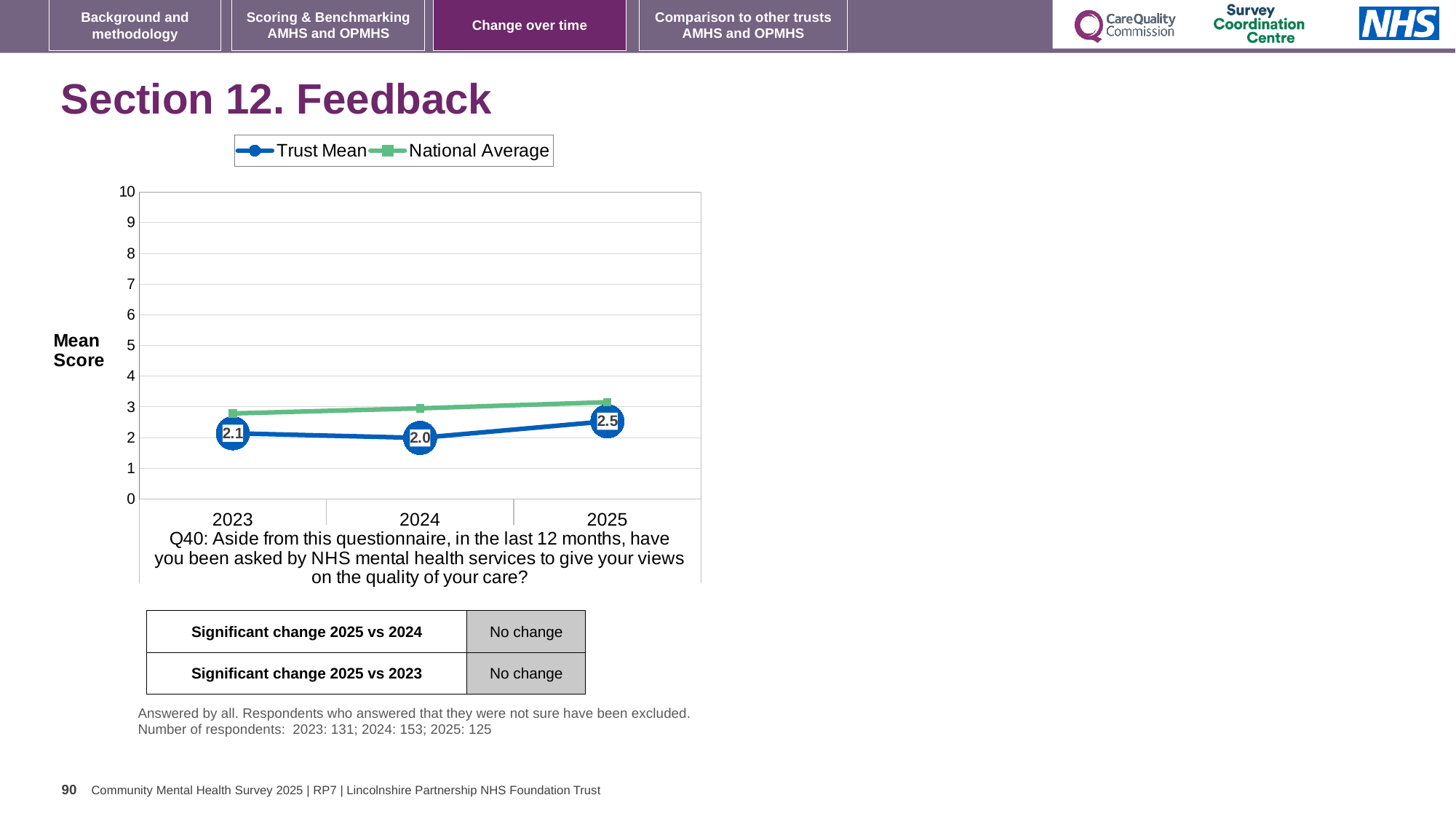
Which is larger, the Trust Mean score for 2025 or for 2023? 2025 Is the National Average value for 2025 greater or less than 5? less How many years are shown on the x axis of the chart? 3 In which year is the Trust Mean score lowest? 2024 How many series does the chart legend list? 2 In which year is the Trust Mean score highest? 2025 What is the Trust Mean score for 2023? 2.1 What is the difference between the Trust Mean scores for 2025 and 2024? 0.5 What is the Trust Mean score for 2024? 2.0 In 2024, which series has the higher value, Trust Mean or National Average? National Average What kind of chart is shown on the slide? line chart What is the Trust Mean score for 2025? 2.5